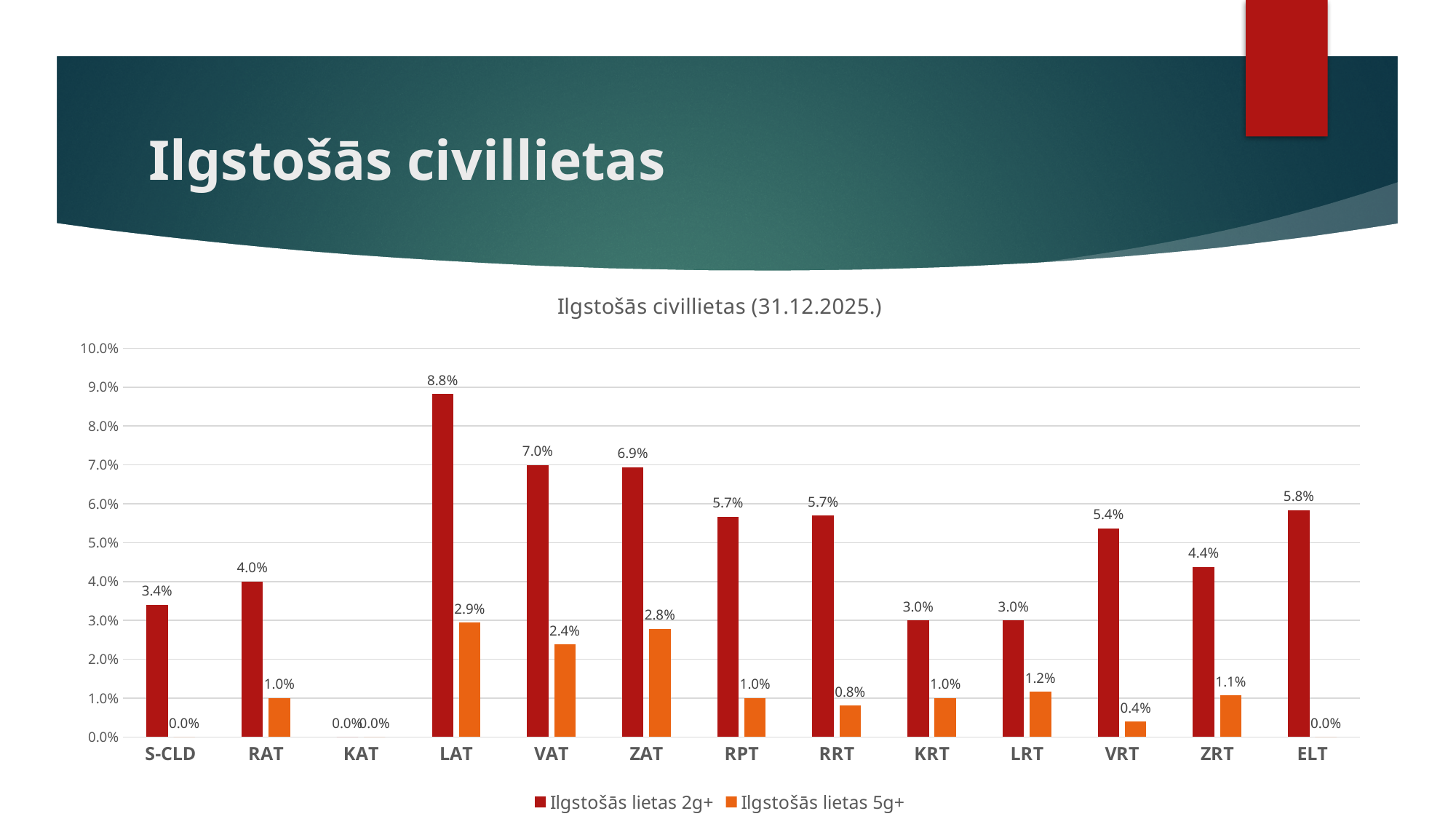
What is the value of Ilgstošās lietas 5g+ for VAT? 2.4% What is the difference between the Ilgstošās lietas 2g+ values for LAT and VAT? 1.8% Which category has the lowest value for Ilgstošās lietas 2g+? KAT Which is larger for Ilgstošās lietas 2g+: RAT or ZRT? ZRT What kind of chart is shown on the slide? Bar chart How many series does the legend list? 2 Which category has the highest value for Ilgstošās lietas 5g+? LAT What is the value of Ilgstošās lietas 2g+ for LAT? 8.8% Which category has the highest value for Ilgstošās lietas 2g+? LAT What is the value of Ilgstošās lietas 2g+ for ELT? 5.8% Is the value of Ilgstošās lietas 2g+ for VRT greater or less than 5.0%? greater How many categories are shown on the x axis? 13